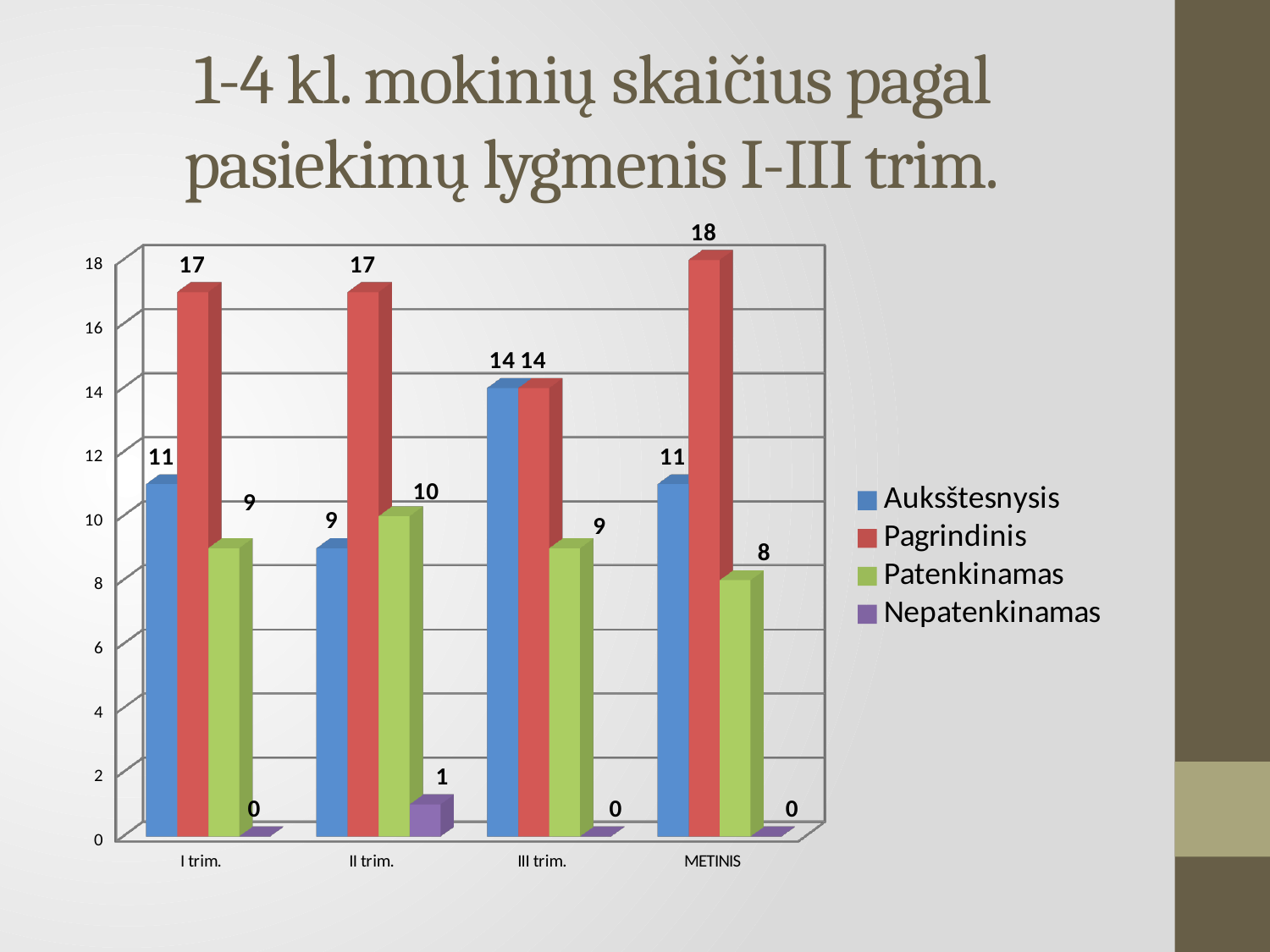
Which colour represents Nepatenkinamas in the legend? purple What kind of chart is shown on the slide? bar chart What is the value for Aukštesnysis in III trim.? 14 How many categories are shown on the x axis? 4 In which category is the Pagrindinis value highest? METINIS In which category is the Patenkinamas value lowest? METINIS What is the difference between Pagrindinis and Aukštesnysis in I trim.? 6 What is the value for Nepatenkinamas in II trim.? 1 What is the value for Patenkinamas in II trim.? 10 Which is larger in II trim., Aukštesnysis or Patenkinamas? Patenkinamas How many series does the legend list? 4 What is the value for Pagrindinis in METINIS? 18